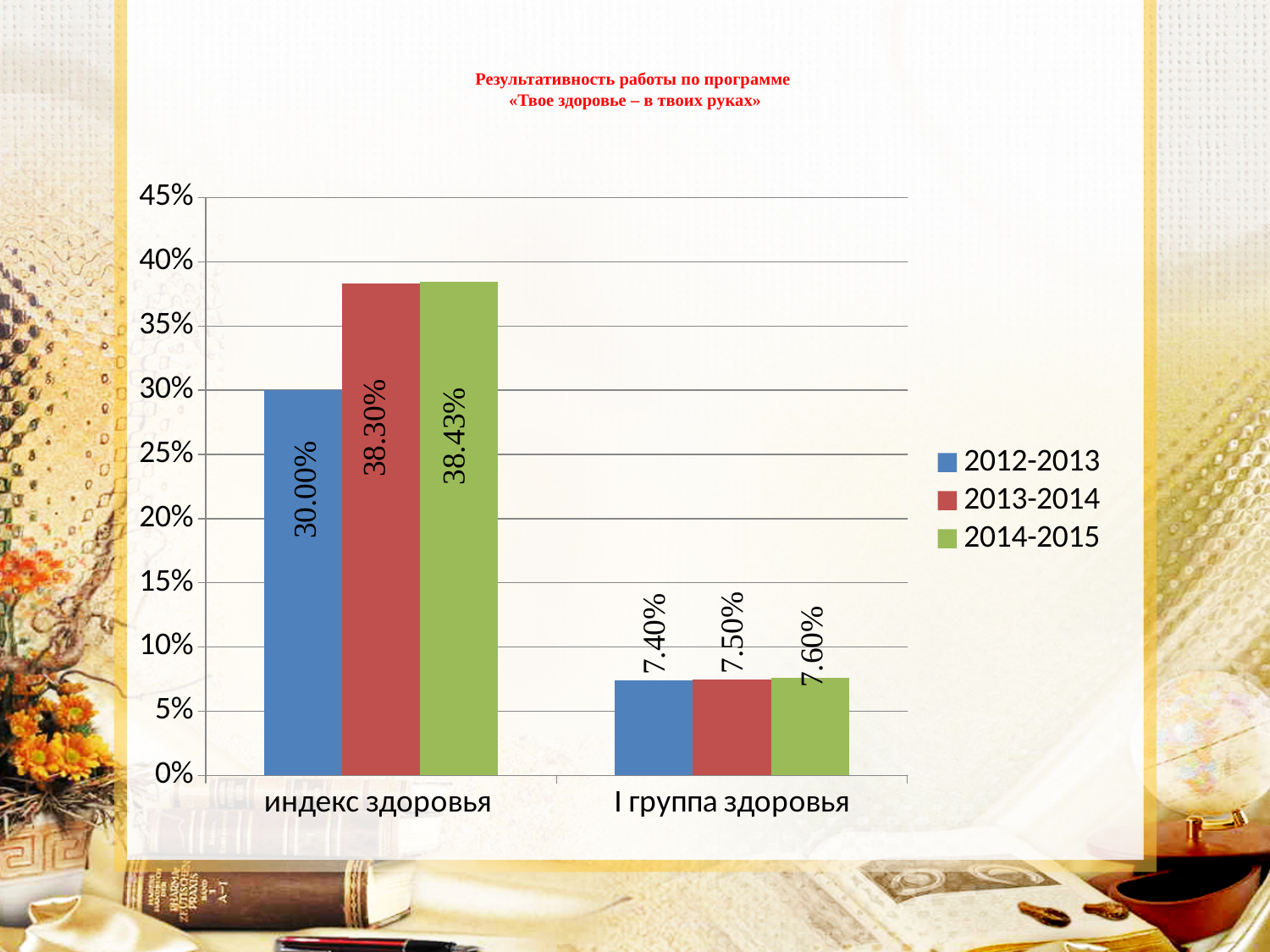
How many series does the legend list? 3 What colour represents the 2013-2014 series in the legend? red What is the difference between the 2013-2014 and 2012-2013 values for "индекс здоровья"? 8.30% Which is larger for "I группа здоровья": the 2012-2013 value or the 2014-2015 value? 2014-2015 What is the value for 2012-2013 in the "индекс здоровья" category? 30.00% How many categories are shown on the x axis? 2 Is the 2012-2013 value for "I группа здоровья" greater or less than 10%? less Which series has the highest value in the "индекс здоровья" category? 2014-2015 What is the value for 2013-2014 in the "индекс здоровья" category? 38.30% Which series has the lowest value in the "I группа здоровья" category? 2012-2013 What is the value for 2014-2015 in the "I группа здоровья" category? 7.60% What kind of chart is shown on the slide? bar chart